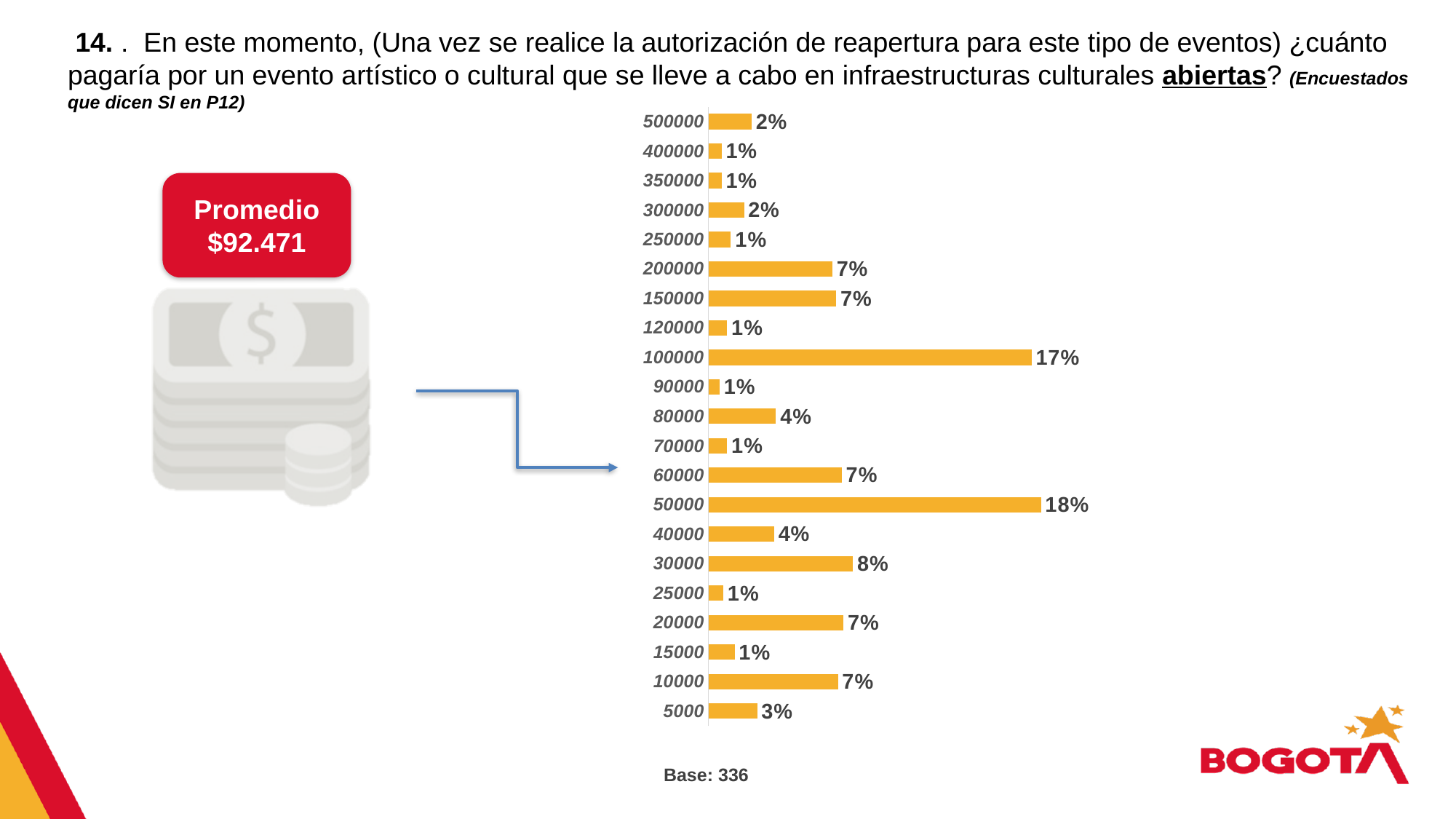
What is the difference between the values for 30000 and 80000? 4% Which price category has the highest percentage? 50000 What percentage is shown for 5000? 3% What is the value shown for the 30000 category? 8% What is the base (number of respondents) shown below the chart? 336 What percentage of respondents would pay 100000? 17% Which has a larger value, 40000 or 60000? 60000 What is the difference between the values for 50000 and 100000? 1% How many price categories are shown on the chart? 21 What kind of chart is shown on the slide? Bar chart What is the lowest percentage value shown on the chart? 1% Which has a larger value, 200000 or 500000? 200000